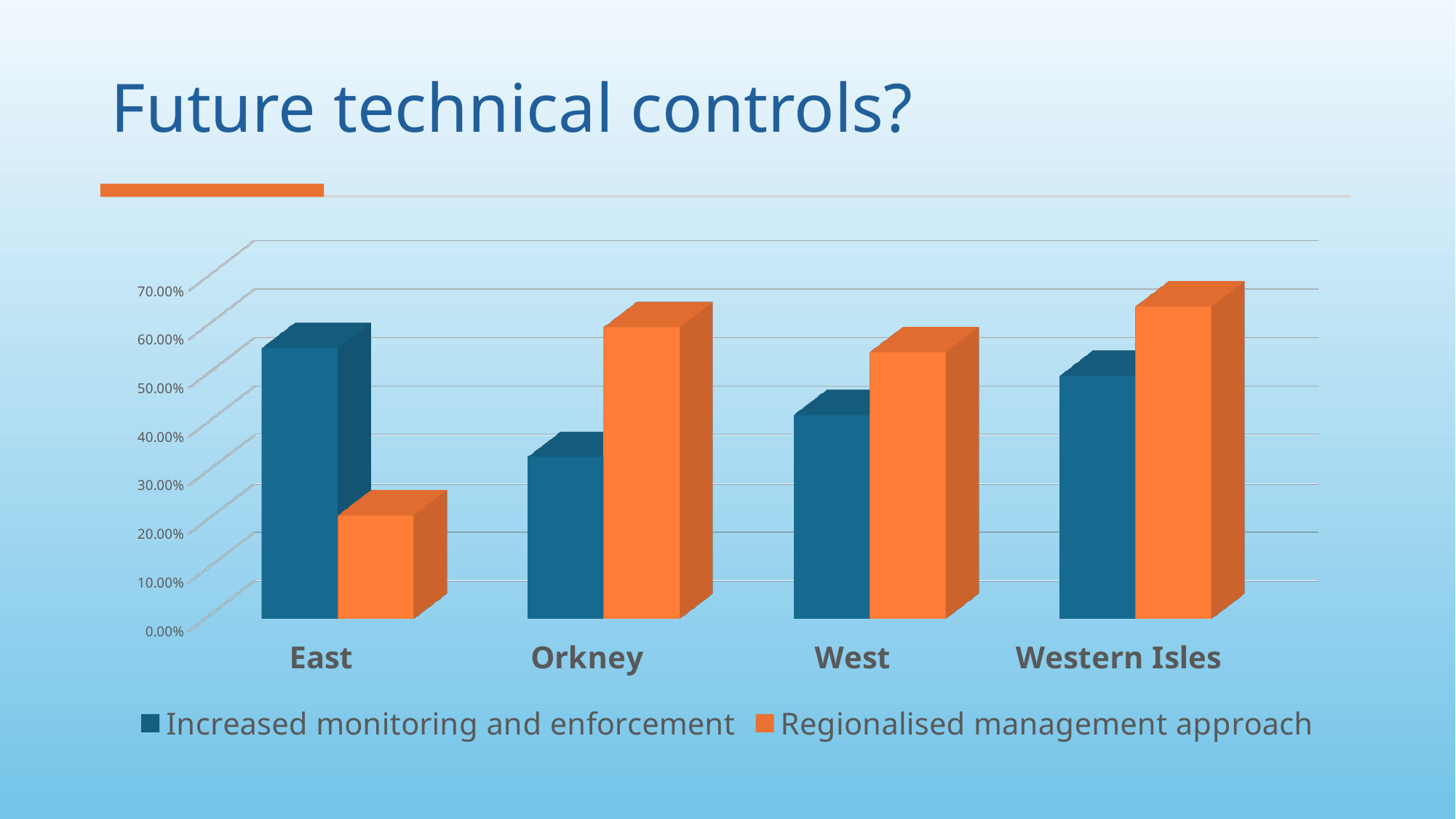
How many regions (categories) are shown on the x axis? 4 For Orkney, which is larger: Increased monitoring and enforcement or Regionalised management approach? Regionalised management approach Which region has the highest value for Increased monitoring and enforcement? East Is the value for Regionalised management approach in Orkney greater or less than 50.00%? greater Which region has the highest value for Regionalised management approach? Western Isles How many series does the legend list? 2 What is the title of the slide containing the chart? Future technical controls? Which region has the lowest value for Increased monitoring and enforcement? Orkney For East, which is larger: Increased monitoring and enforcement or Regionalised management approach? Increased monitoring and enforcement Is the value for Regionalised management approach in East greater or less than 30.00%? less Which region has the lowest value for Regionalised management approach? East What kind of chart is shown on the slide? Bar chart